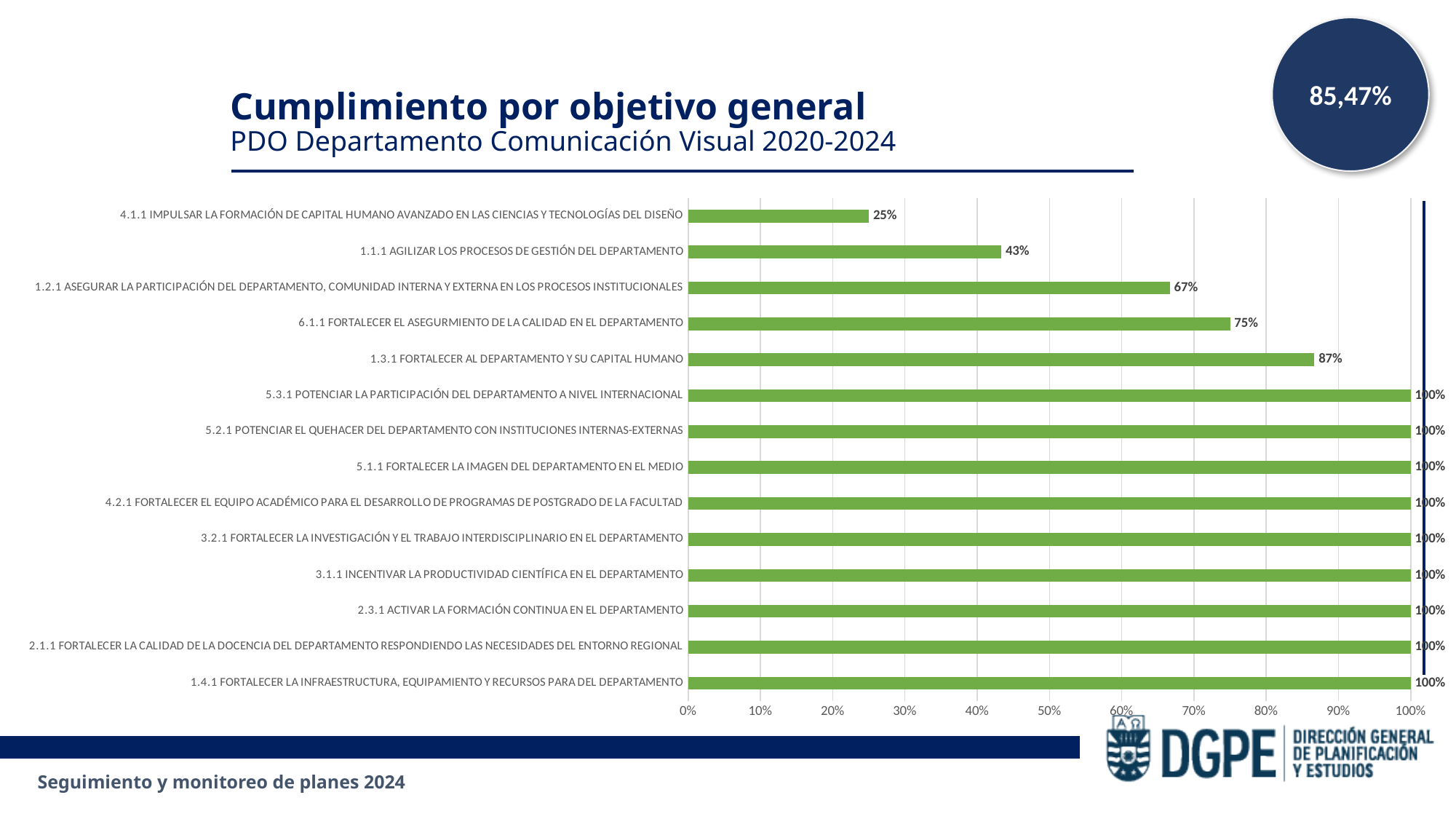
What is the value for 1.3.1 FORTALECER AL DEPARTAMENTO Y SU CAPITAL HUMANO? 87% What overall percentage is shown in the circle at the top right of the slide? 85,47% What kind of chart is shown on the slide? Bar chart What is the value for 1.1.1 AGILIZAR LOS PROCESOS DE GESTIÓN DEL DEPARTAMENTO? 43% Is the value for 1.2.1 ASEGURAR LA PARTICIPACIÓN DEL DEPARTAMENTO greater or less than 60%? greater How many objectives in the chart have a value of 100%? 9 How many objectives (categories) are plotted in the chart? 14 Which has a larger value: 1.1.1 AGILIZAR LOS PROCESOS DE GESTIÓN DEL DEPARTAMENTO or 1.2.1 ASEGURAR LA PARTICIPACIÓN DEL DEPARTAMENTO, COMUNIDAD INTERNA Y EXTERNA EN LOS PROCESOS INSTITUCIONALES? 1.2.1 ASEGURAR LA PARTICIPACIÓN DEL DEPARTAMENTO, COMUNIDAD INTERNA Y EXTERNA EN LOS PROCESOS INSTITUCIONALES What is the difference between the value for 1.3.1 FORTALECER AL DEPARTAMENTO Y SU CAPITAL HUMANO and the value for 4.1.1 IMPULSAR LA FORMACIÓN DE CAPITAL HUMANO AVANZADO? 62 percentage points Which objective has the lowest value in the chart? 4.1.1 IMPULSAR LA FORMACIÓN DE CAPITAL HUMANO AVANZADO EN LAS CIENCIAS Y TECNOLOGÍAS DEL DISEÑO What is the value for 6.1.1 FORTALECER EL ASEGURMIENTO DE LA CALIDAD EN EL DEPARTAMENTO? 75% What is the value for 4.1.1 IMPULSAR LA FORMACIÓN DE CAPITAL HUMANO AVANZADO EN LAS CIENCIAS Y TECNOLOGÍAS DEL DISEÑO? 25%